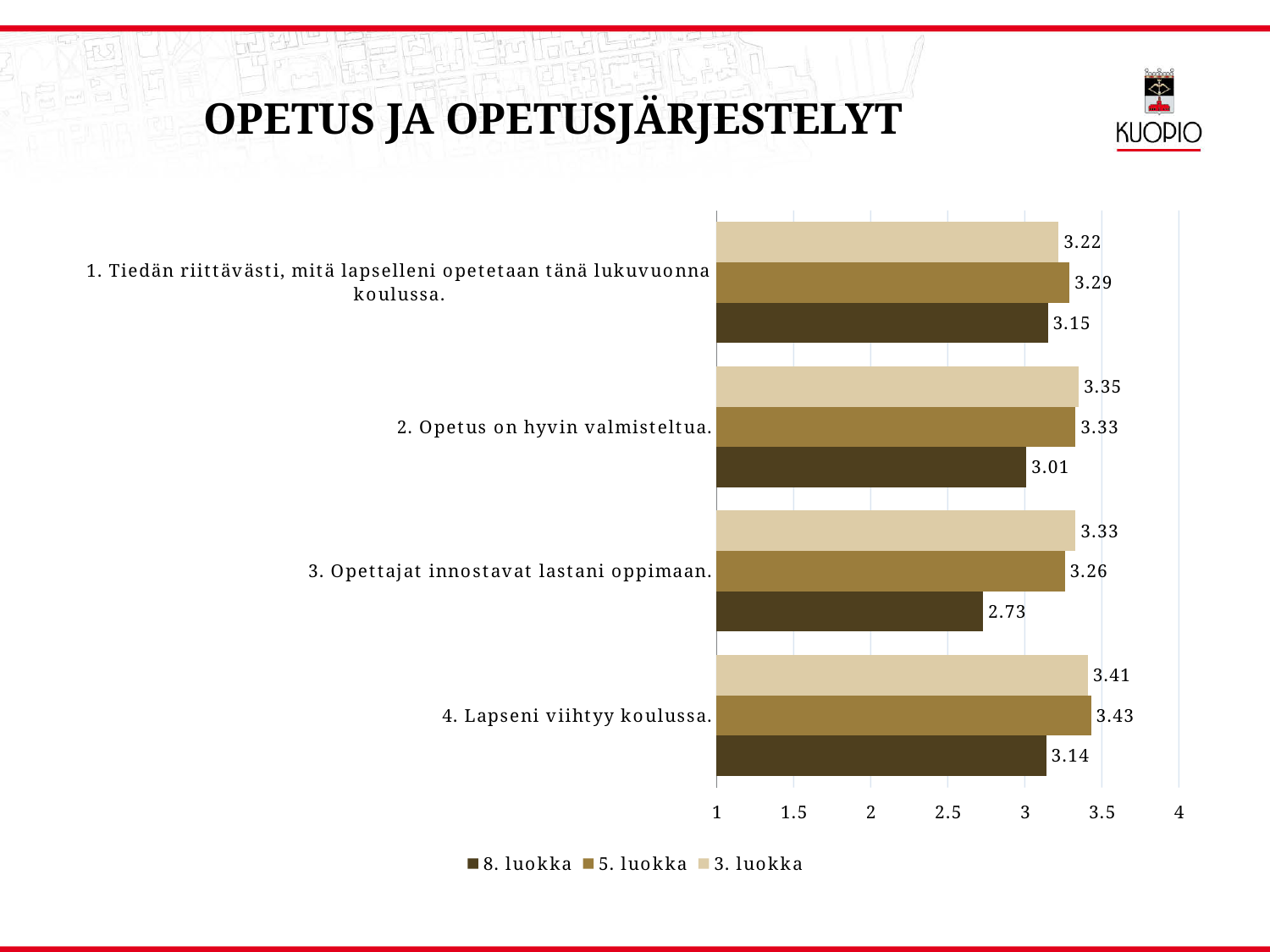
What is the title of the slide? OPETUS JA OPETUSJÄRJESTELYT Which statement has the highest value for 5. luokka? 4. Lapseni viihtyy koulussa. For "2. Opetus on hyvin valmisteltua.", which is larger: the value for 5. luokka or for 8. luokka? 5. luokka What is the value for 8. luokka for "3. Opettajat innostavat lastani oppimaan."? 2.73 How many statements (categories) are shown on the chart? 4 What kind of chart is shown on the slide? Bar chart What is the value for 3. luokka for "2. Opetus on hyvin valmisteltua."? 3.35 Which statement has the lowest value for 8. luokka? 3. Opettajat innostavat lastani oppimaan. How many series does the legend list? 3 What is the value for 8. luokka for "1. Tiedän riittävästi, mitä lapselleni opetetaan tänä lukuvuonna koulussa."? 3.15 What is the value for 5. luokka for "4. Lapseni viihtyy koulussa."? 3.43 What is the difference between the 3. luokka and 8. luokka values for "3. Opettajat innostavat lastani oppimaan."? 0.60